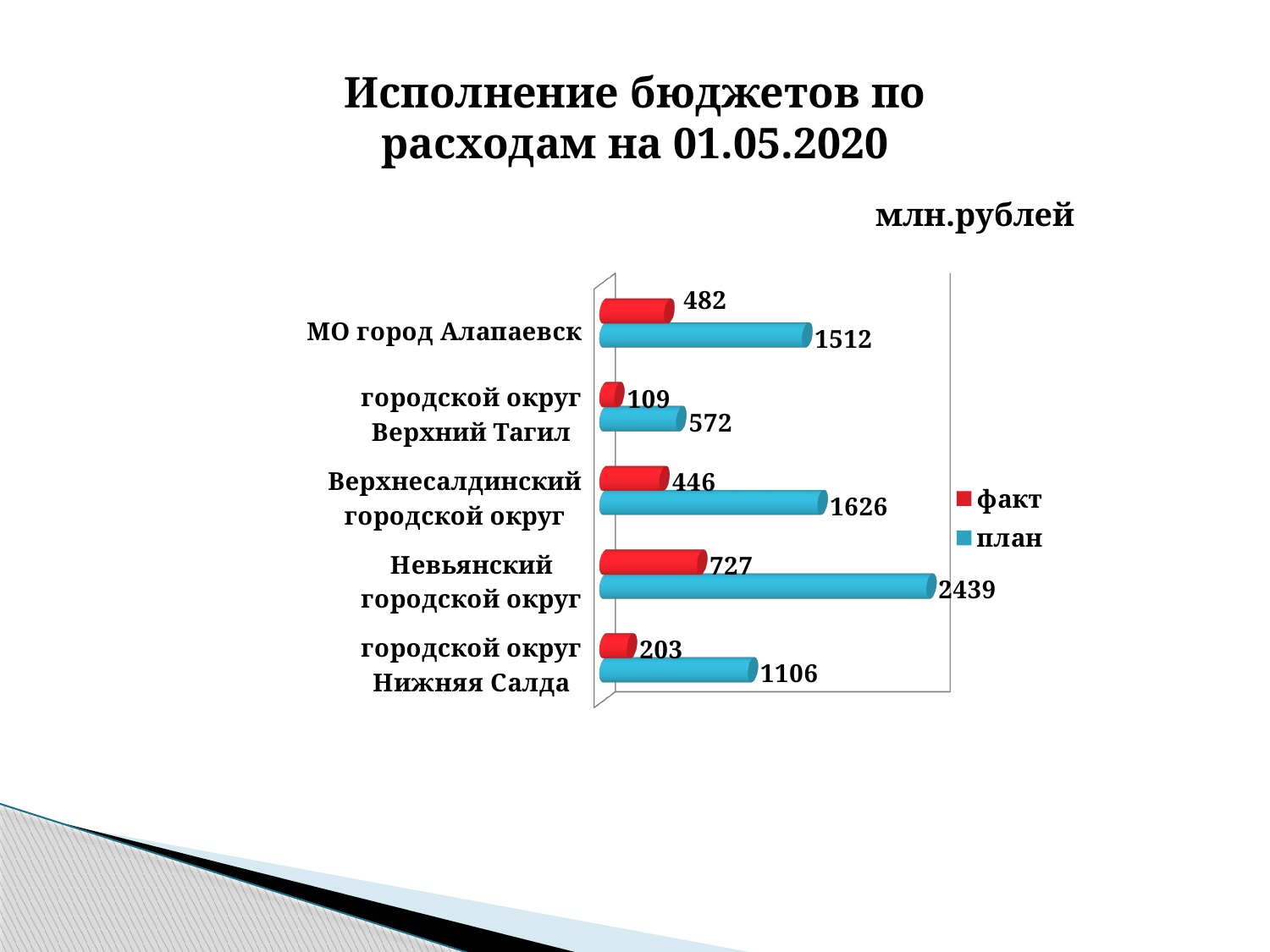
How many categories are shown on the chart? 5 Which category has the highest план value? Невьянский городской округ How many series does the legend list? 2 Which is larger: the факт value for МО город Алапаевск or the факт value for Верхнесалдинский городской округ? МО город Алапаевск What kind of chart is shown on the slide? bar chart What is the difference between the план and факт values for Верхнесалдинский городской округ? 1180 What unit is stated above the chart? млн.рублей What is the план value for Невьянский городской округ? 2439 What is the факт value for городской округ Нижняя Салда? 203 Which category has the lowest факт value? городской округ Верхний Тагил What is the факт value for МО город Алапаевск? 482 What is the план value for городской округ Верхний Тагил? 572